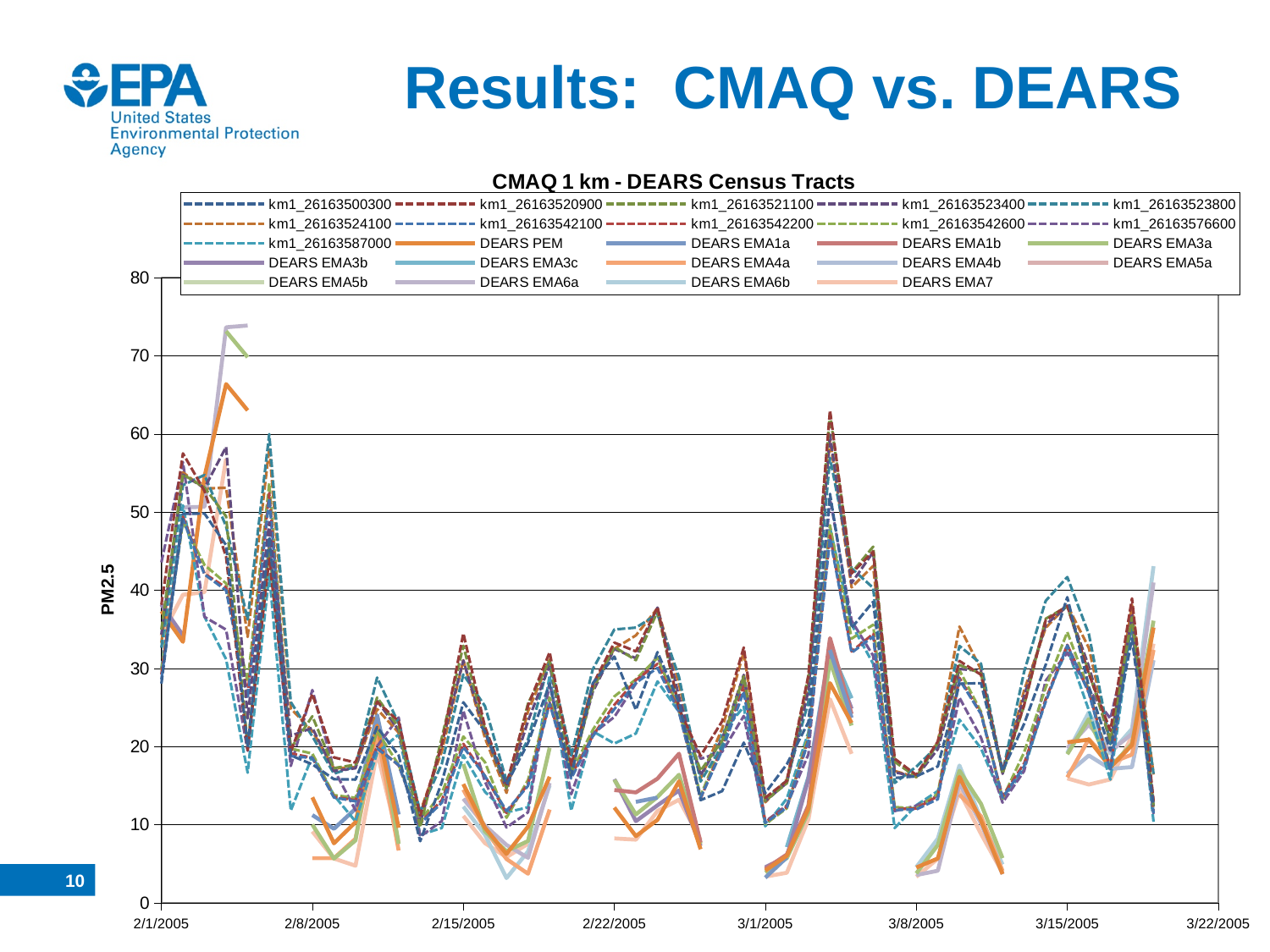
What is the title of the chart? CMAQ 1 km - DEARS Census Tracts Is the tallest peak of the dashed km1 lines, just after 3/1/2005, greater or less than 50? greater How many series does the chart's legend list? 24 Is the lowest point of the DEARS lines around 2/17/2005 greater or less than 10? less Is the value of the dashed km1 lines at the final point, around 3/19/2005, greater or less than 20? less What is the label on the vertical axis of the chart? PM2.5 What is the last date shown on the horizontal axis of the chart? 3/22/2005 How many date tick labels are shown along the horizontal axis of the chart? 8 What kind of chart is shown on the slide? line chart What is the first date shown on the horizontal axis of the chart? 2/1/2005 What is the highest value shown on the vertical axis of the chart? 80